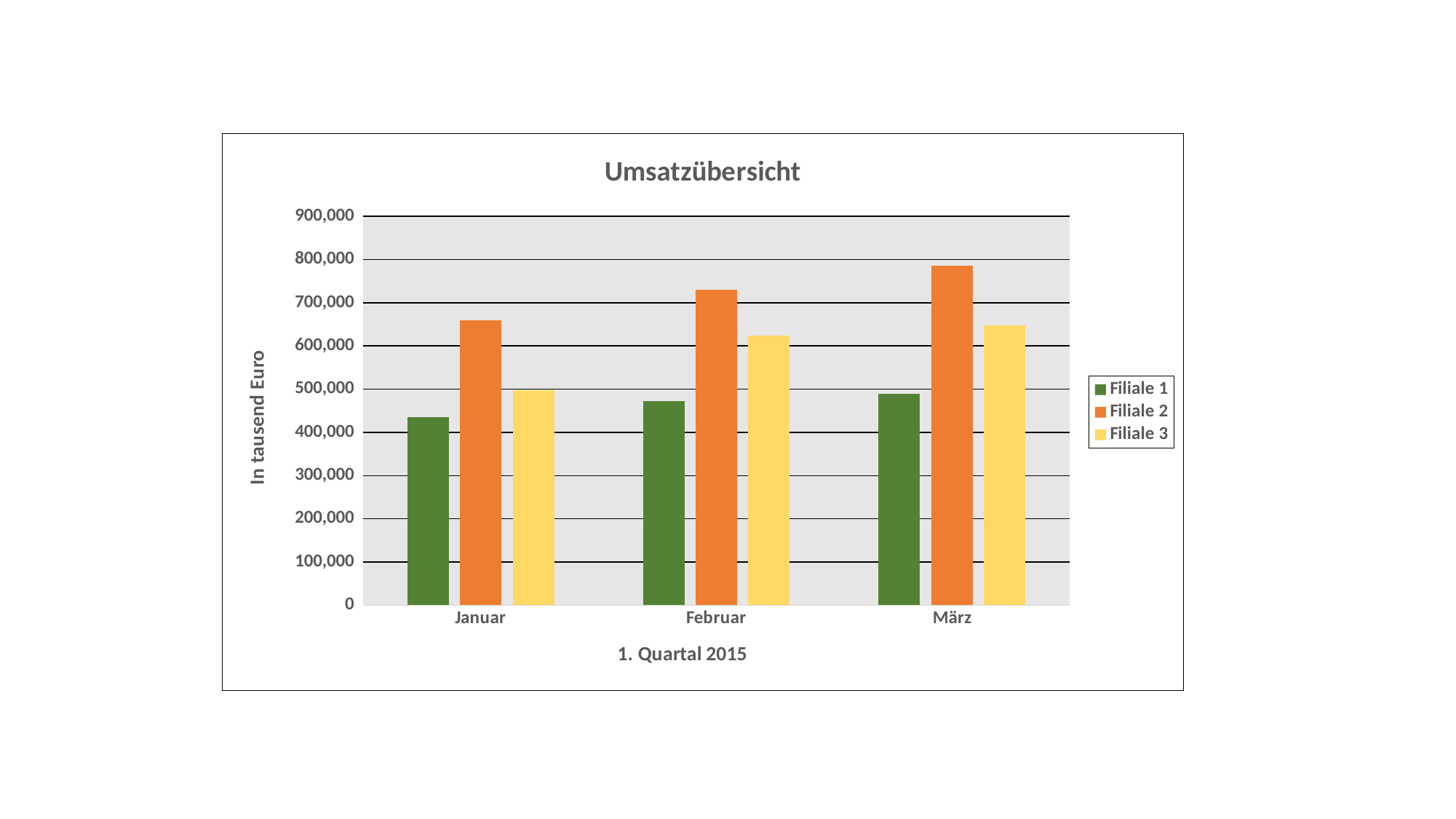
Which is larger in Februar, Filiale 1 or Filiale 3? Filiale 3 Do the values for Filiale 2 rise or fall from Januar to März? rise Which series has the lowest value in Januar? Filiale 1 Is the value for Filiale 3 in März greater or less than 600,000? greater Which series has the highest value in März? Filiale 2 How many series does the legend list? 3 Is the value for Filiale 1 in Januar greater or less than 500,000? less How many months are shown on the x axis? 3 What is the title of the chart? Umsatzübersicht What kind of chart is shown on the slide? bar chart Is the value for Filiale 2 in Januar greater or less than 600,000? greater